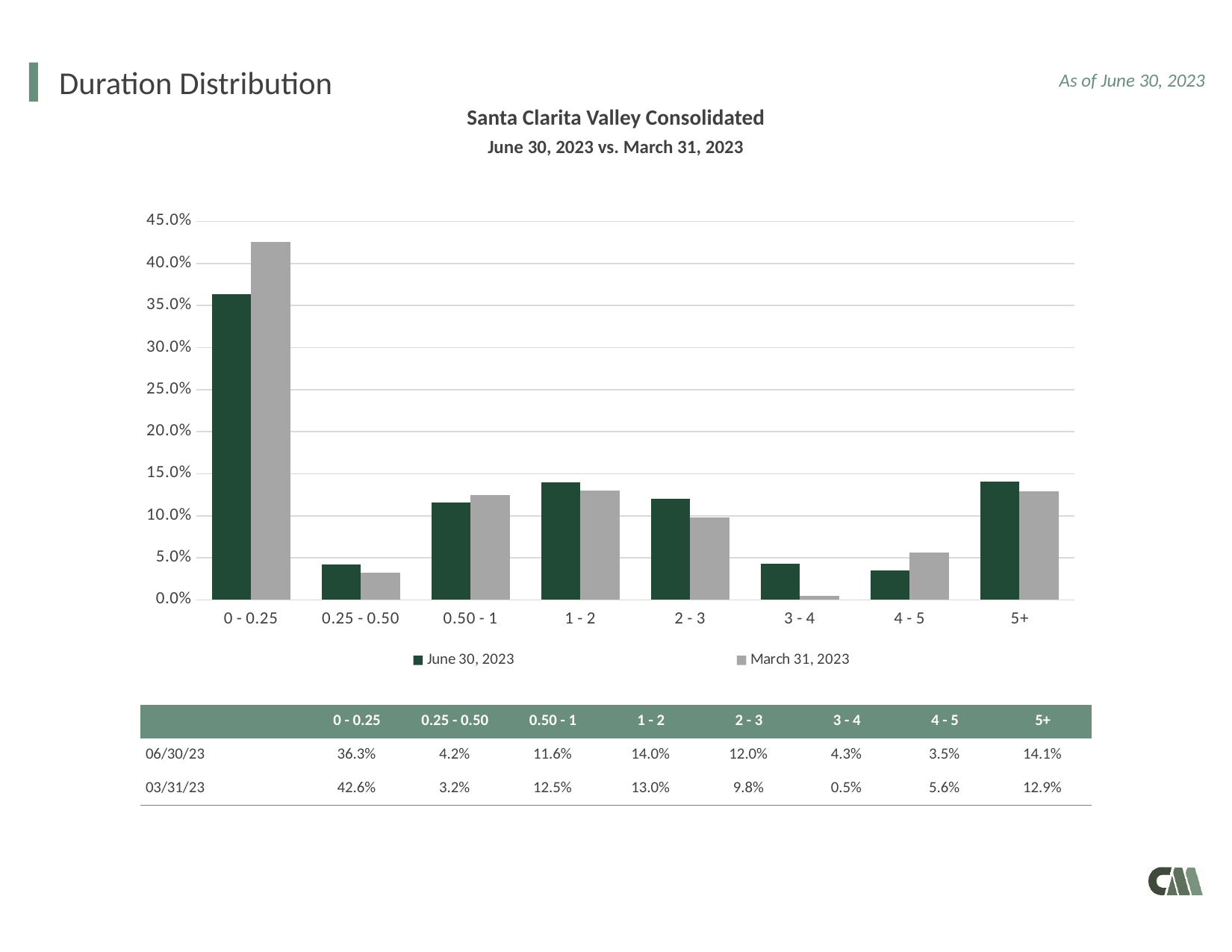
Which duration bucket has the highest June 30, 2023 value? 0 - 0.25 What is the difference between the March 31, 2023 and June 30, 2023 values for the 0 - 0.25 bucket? 6.3% What kind of chart is shown on the slide? Bar chart What is the June 30, 2023 value for the 0 - 0.25 duration bucket? 36.3% For the 4 - 5 bucket, which is larger: the June 30, 2023 value or the March 31, 2023 value? March 31, 2023 What is the March 31, 2023 value for the 3 - 4 duration bucket? 0.5% Which duration bucket has the lowest March 31, 2023 value? 3 - 4 How many series does the legend list? 2 Is the March 31, 2023 value for the 0 - 0.25 bucket greater or less than 40.0%? greater What is the title of the chart? Santa Clarita Valley Consolidated How many duration buckets are shown on the x axis? 8 What is the March 31, 2023 value for the 5+ duration bucket? 12.9%